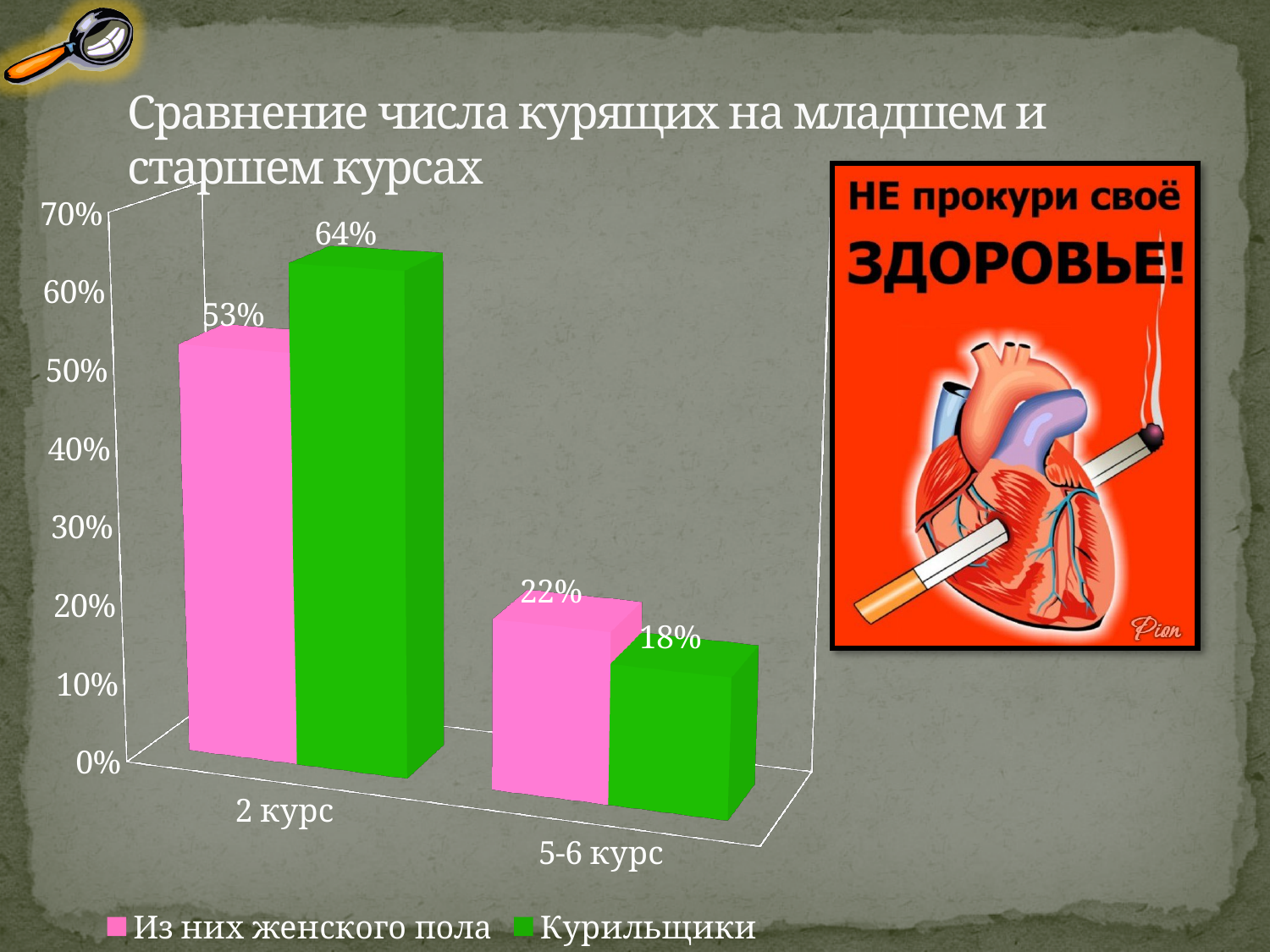
What kind of chart is shown on the slide? Bar chart Which category has the lowest value for the "Из них женского пола" series? 5-6 курс In the "5-6 курс" category, which series has the larger value: "Из них женского пола" or "Курильщики"? Из них женского пола What colour represents the "Курильщики" series? Green What is the difference between the "Курильщики" values for "2 курс" and "5-6 курс"? 46% What is the value for "Курильщики" in the "5-6 курс" category? 18% What is the value for "Курильщики" in the "2 курс" category? 64% What is the value for "Из них женского пола" in the "5-6 курс" category? 22% How many categories are shown on the x axis? 2 Which category has the highest value for the "Курильщики" series? 2 курс What is the value for "Из них женского пола" in the "2 курс" category? 53% How many series does the legend list? 2